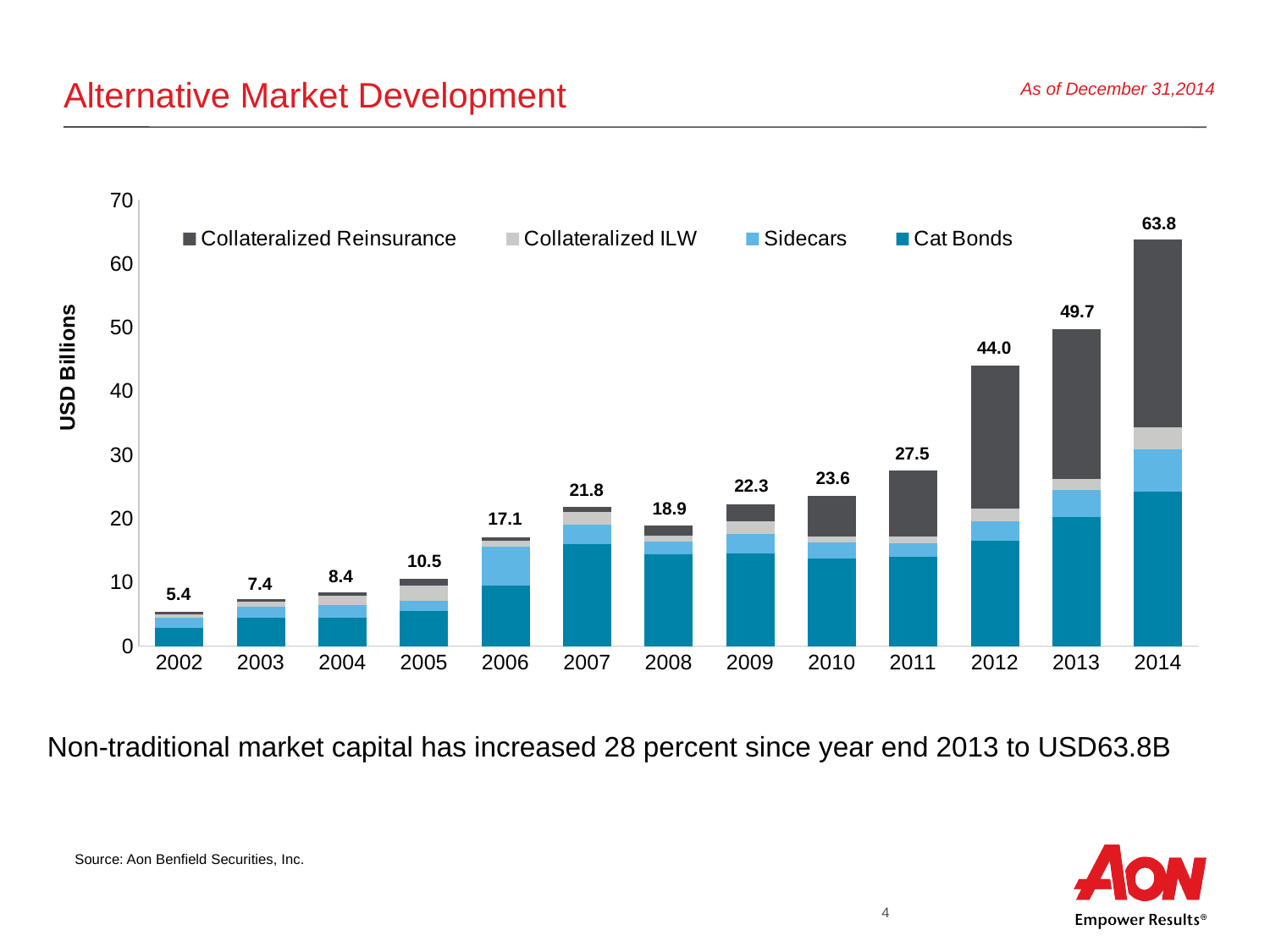
Is the Cat Bonds value for 2014 greater or less than 20? greater What kind of chart is shown on the slide? Stacked bar chart What is the difference between the total for 2014 and the total for 2013? 14.1 How many series does the legend list? 4 Which year has the lowest total value? 2002 What is the total value shown for 2008? 18.9 Which year has the highest total value? 2014 Which year has the larger total, 2008 or 2009? 2009 Do the total values generally rise or fall from 2002 to 2014? Rise What is the label on the y axis of the chart? USD Billions What is the total value shown for 2014? 63.8 How many years are shown on the x axis? 13